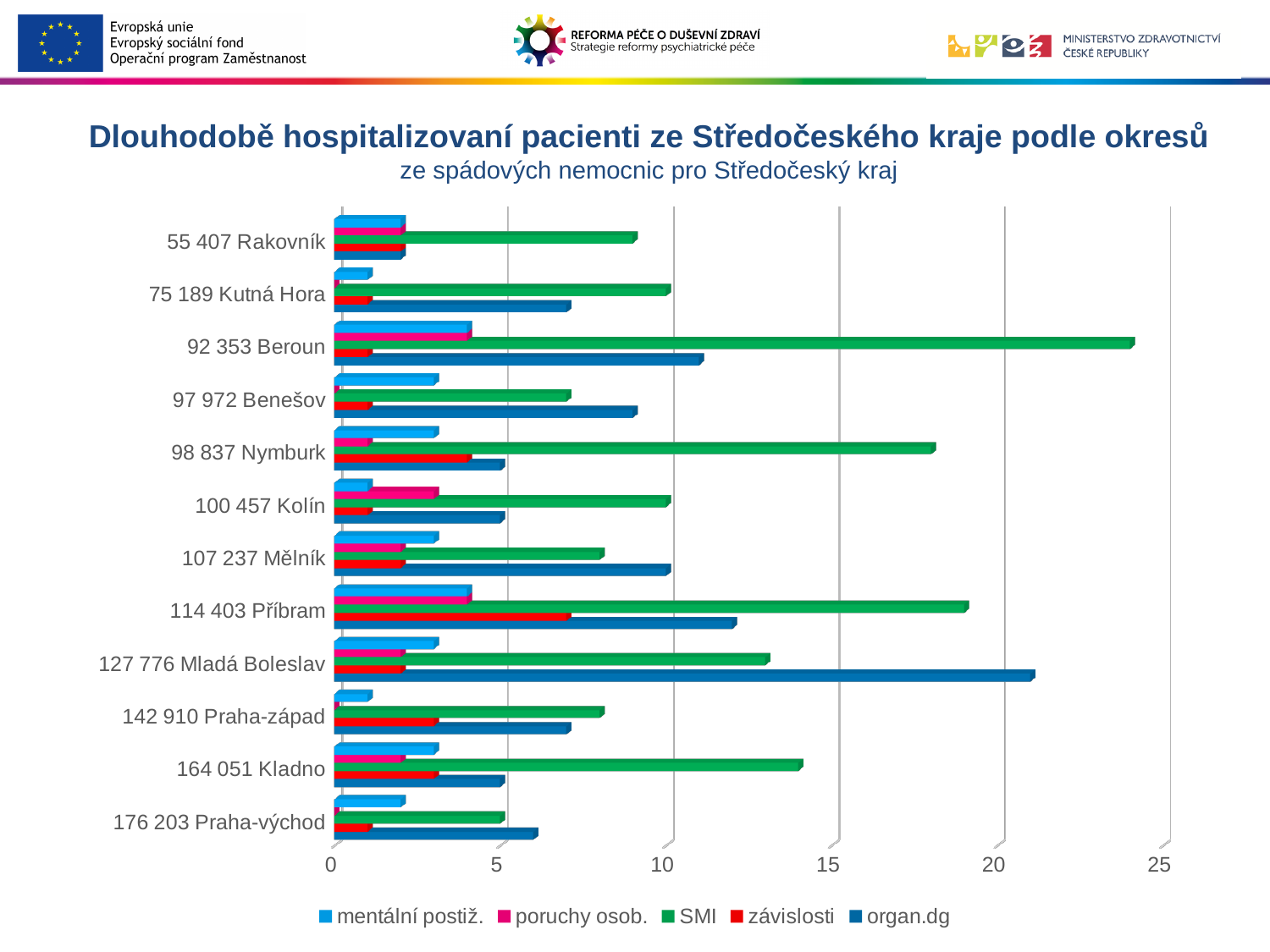
Which district has the highest organ.dg value? 127 776 Mladá Boleslav Which is larger for 127 776 Mladá Boleslav: the SMI value or the organ.dg value? organ.dg Which district has the highest SMI value? 92 353 Beroun Which is larger for 114 403 Příbram: the SMI value or the organ.dg value? SMI How many districts (categories) are plotted on the chart? 12 What is the subtitle shown under the chart title? ze spádových nemocnic pro Středočeský kraj What kind of chart is shown on the slide? bar chart Is the SMI value for 176 203 Praha-východ greater or less than 10? less Is the SMI value for 92 353 Beroun greater or less than 20? greater Is the organ.dg value for 127 776 Mladá Boleslav greater or less than 20? greater How many series does the legend list? 5